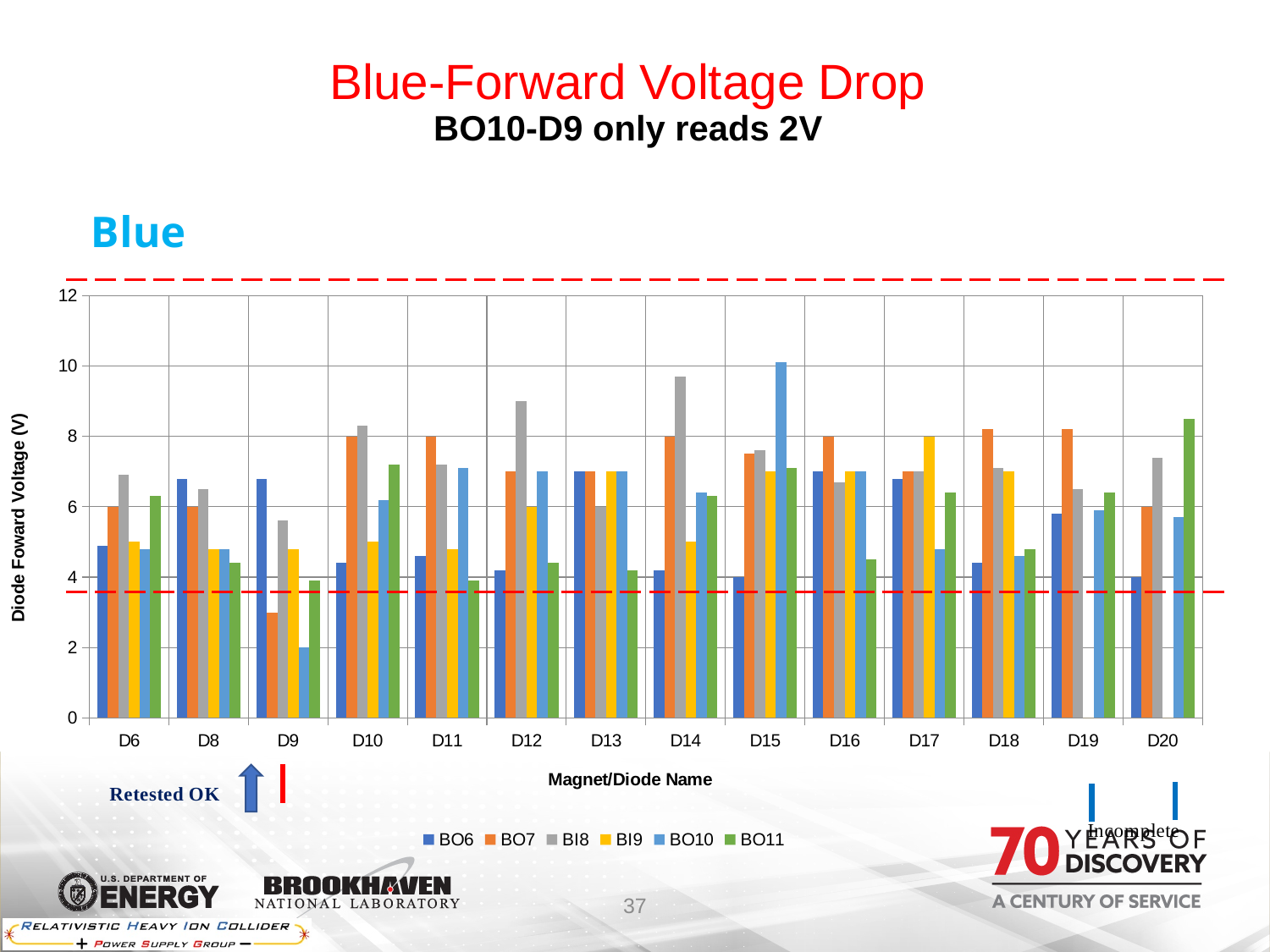
What kind of chart is shown on the slide? bar chart At D14, which series has the highest value? BI8 How many magnet/diode categories are shown on the x axis? 14 Is the value for BO7 at D9 greater or less than 4? less At D15, which series has the highest value? BO10 What is the value for BO10 at D9? 2 What is the title of the x axis? Magnet/Diode Name At D20, which series has the highest value? BO11 At D9, which series has the lowest value? BO10 At D6, which is larger, BI8 or BO6? BI8 Is the value for BI8 at D12 greater or less than 8? greater How many series does the legend list? 6